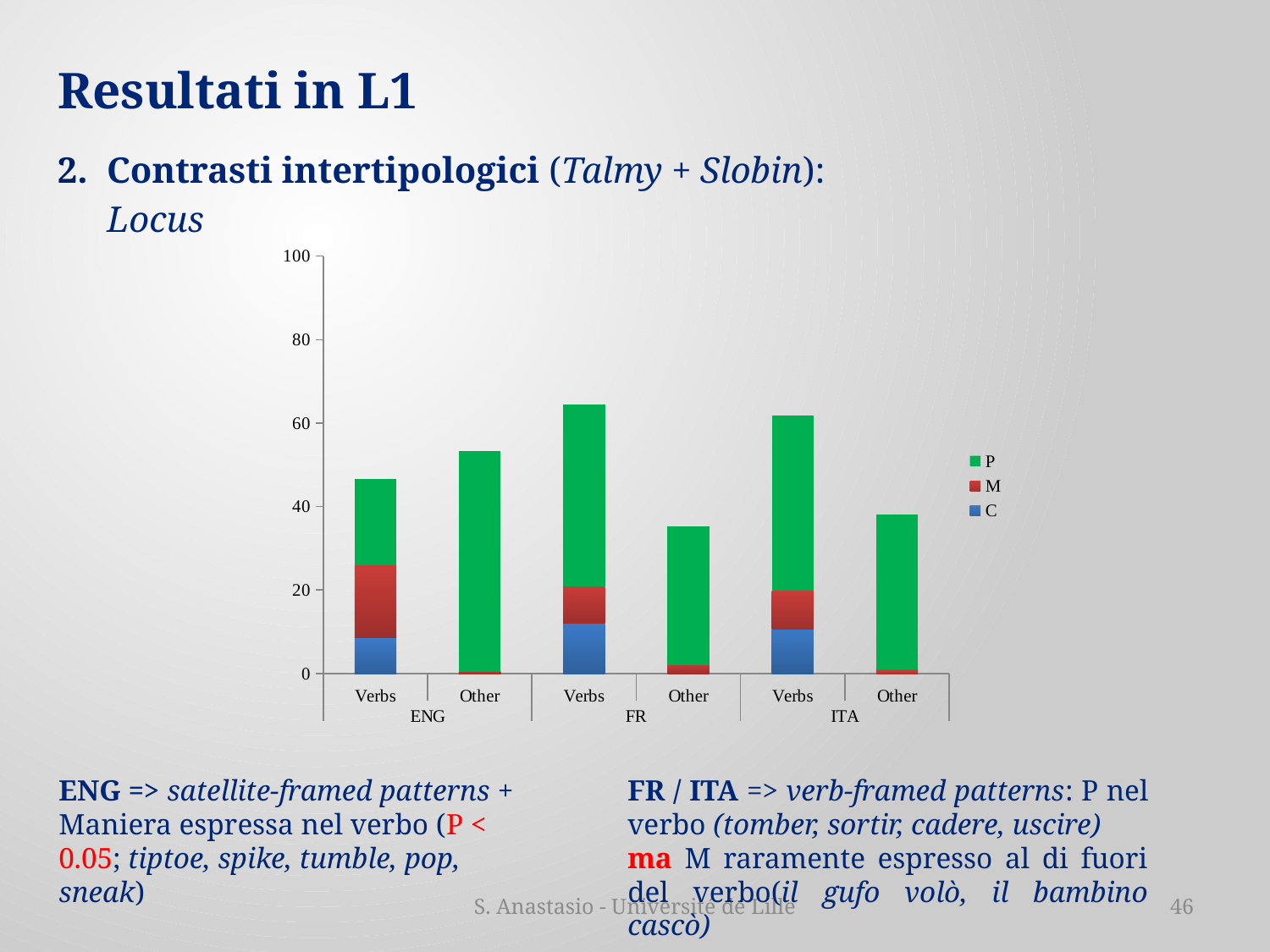
Is the total value of the ENG Verbs bar greater or less than 60? less How many bars are plotted in the chart? 6 Is the total value of the ENG Other bar greater or less than 40? greater Within the ENG group, which bar has the larger total, Verbs or Other? Other Which series are listed in the chart legend? P, M, C What kind of chart is shown on the slide? stacked bar chart How many series does the chart legend list? 3 Within the FR group, which bar has the larger total, Verbs or Other? Verbs What colour represents the P series in the chart? green Is the total value of the ITA Verbs bar greater or less than 40? greater